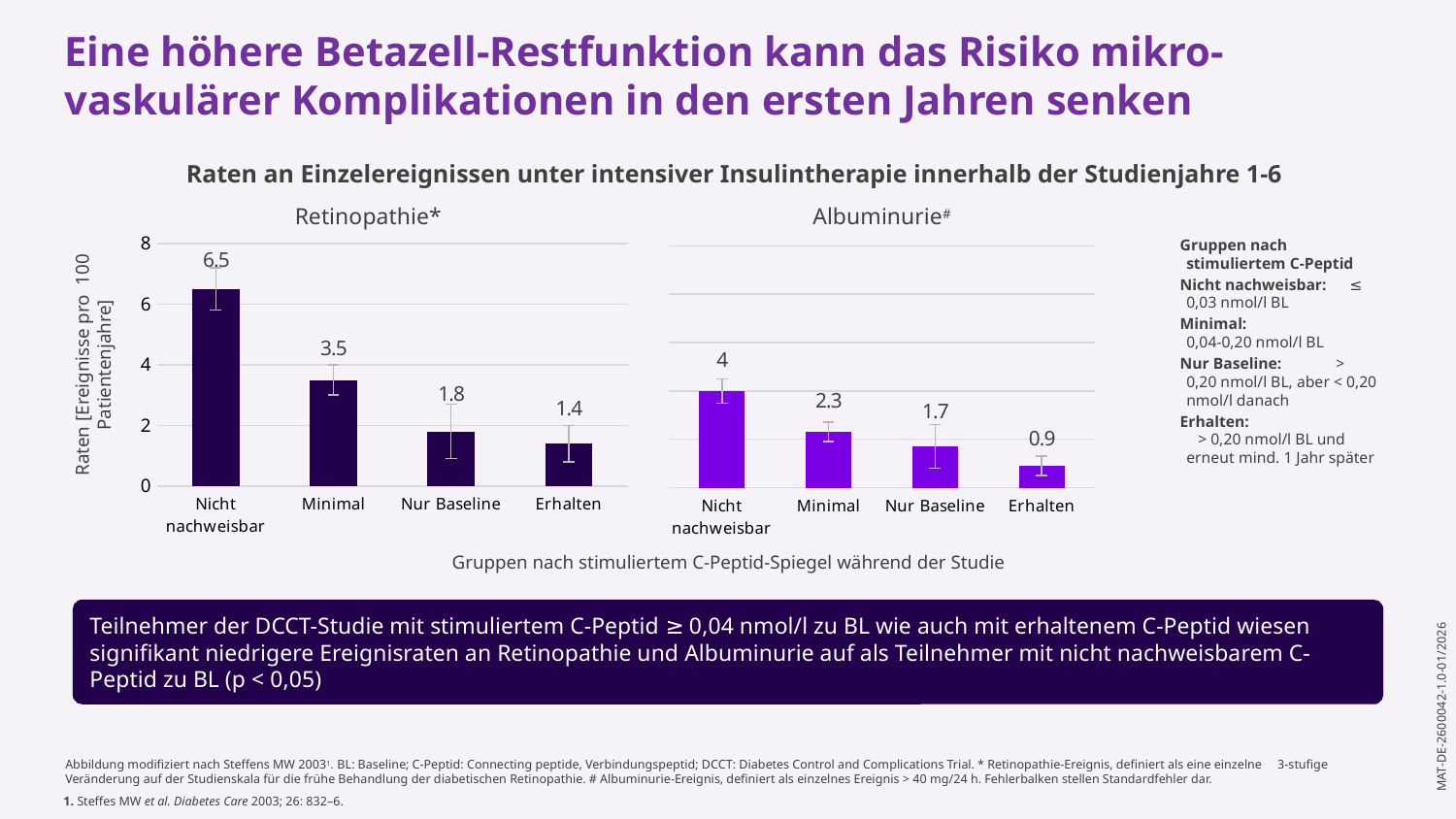
In the Retinopathie chart, what is the value for the Nicht nachweisbar group? 6,5 In the Retinopathie chart, is the value for Nicht nachweisbar greater or less than 6? greater In the Retinopathie chart, which is larger: the value for Nur Baseline or the value for Erhalten? Nur Baseline In the Retinopathie chart, which group has the highest rate? Nicht nachweisbar How many groups are shown on the x axis of the Albuminurie chart? 4 In the Albuminurie chart, what is the value for the Erhalten group? 0,9 What kind of chart is the Retinopathie chart? bar chart In the Albuminurie chart, what is the difference between the Nicht nachweisbar and Erhalten values? 3,1 In the Albuminurie chart, which group has the lowest rate? Erhalten In the Albuminurie chart, what is the value for the Minimal group? 2,3 In the Retinopathie chart, what is the difference between the Nicht nachweisbar and Minimal values? 3 In the Albuminurie chart, do the values rise or fall from left to right along the x axis? fall